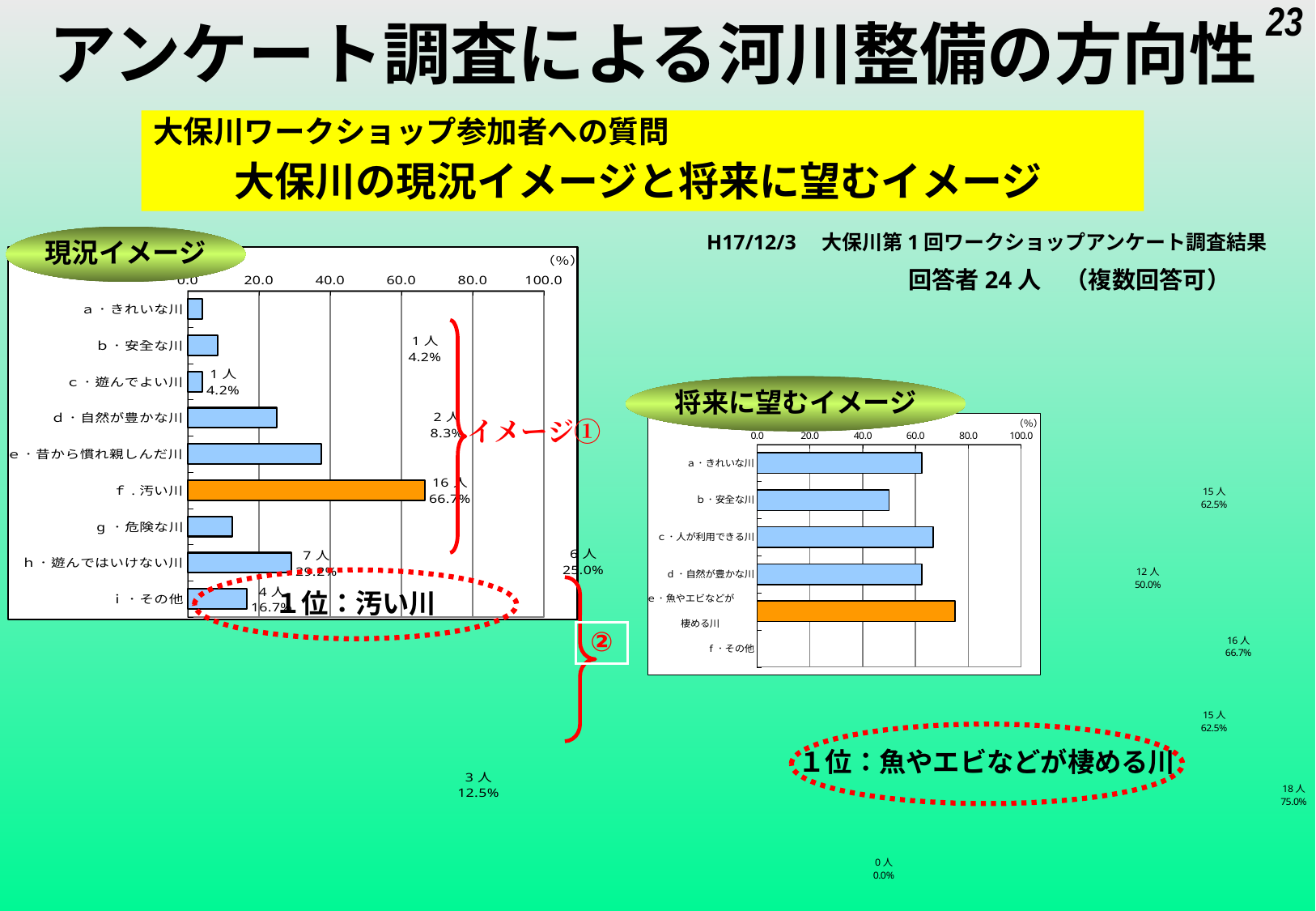
In the 現況イメージ chart, is the value for a・きれいな川 greater or less than 20.0? less In the 現況イメージ chart, what is the difference in percentage points between f．汚い川 (66.7%) and h・遊んではいけない川 (29.2%)? 37.5 In the 将来に望むイメージ chart, is the value for b・安全な川 greater or less than 40.0? greater How many categories does the 現況イメージ chart show? 9 In the 現況イメージ chart, which category has the highest value? f．汚い川 In the 将来に望むイメージ chart, which category has the highest value? e・魚やエビなどが棲める川 How many categories does the 将来に望むイメージ chart show? 6 What kind of chart is the 現況イメージ chart? bar chart In the 現況イメージ chart, which is larger: d・自然が豊かな川 or e・昔から慣れ親しんだ川? e・昔から慣れ親しんだ川 In the 現況イメージ chart, how many people chose h・遊んではいけない川? 7人 In the 現況イメージ chart, what percentage is shown for i・その他? 16.7% In the 現況イメージ chart, what percentage is shown for f．汚い川? 66.7%